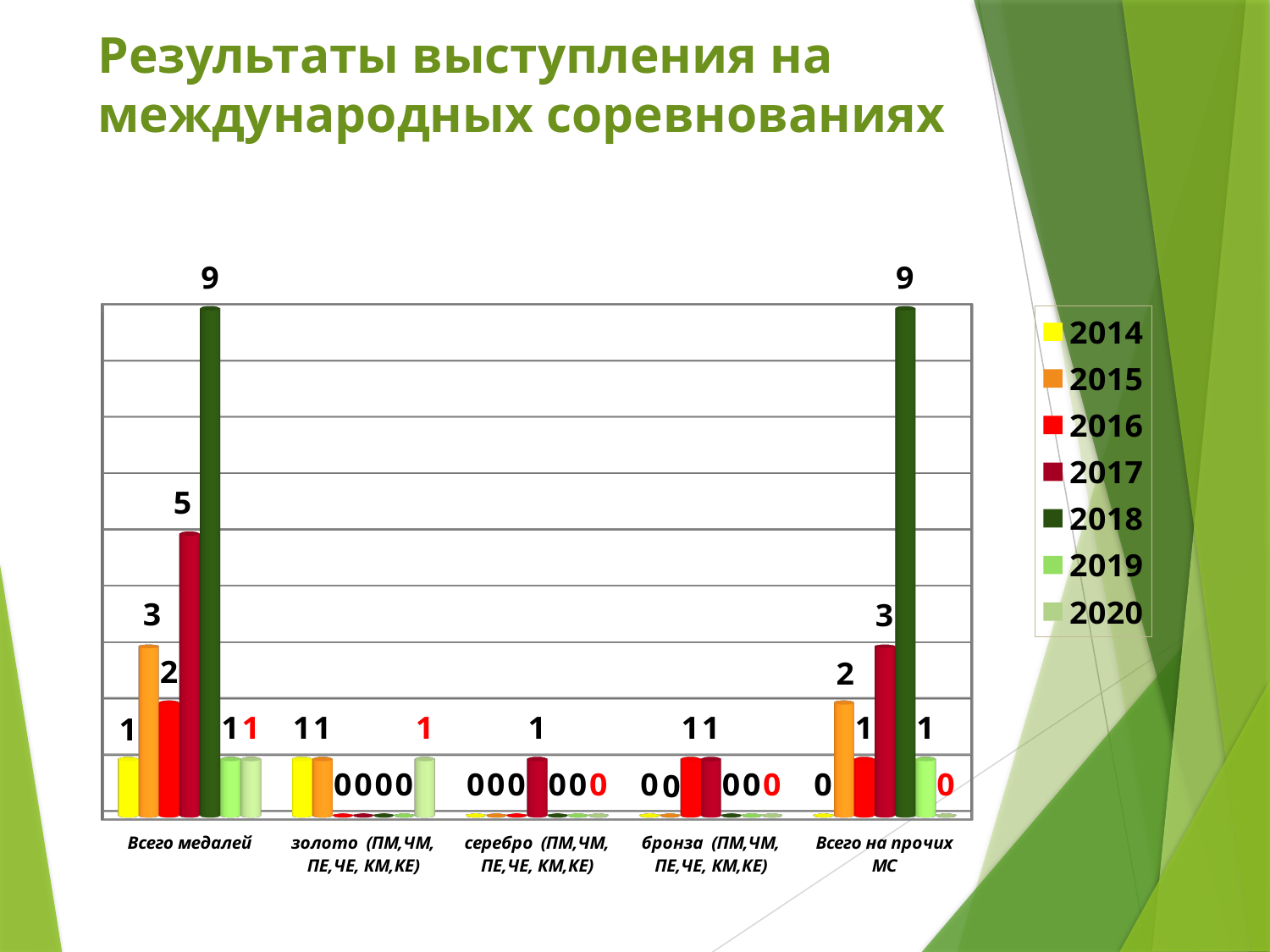
What kind of chart is shown on the slide? Bar chart What is the value for 2017 in the "Всего медалей" category? 5 How many series does the legend list? 7 Which year has the highest value in the "Всего медалей" category? 2018 What is the value for 2015 in the "Всего на прочих МС" category? 2 How many categories are shown on the x axis of the chart? 5 What is the difference between the 2015 and 2016 values in the "Всего медалей" category? 1 Which year has the highest value in the "Всего на прочих МС" category? 2018 What is the value for 2017 in the "серебро (ПМ,ЧМ, ПЕ,ЧЕ, КМ,КЕ)" category? 1 In the "Всего на прочих МС" category, which is larger: the value for 2017 or the value for 2015? 2017 What is the difference between the 2018 and 2017 values in the "Всего медалей" category? 4 What is the value for 2018 in the "Всего медалей" category? 9